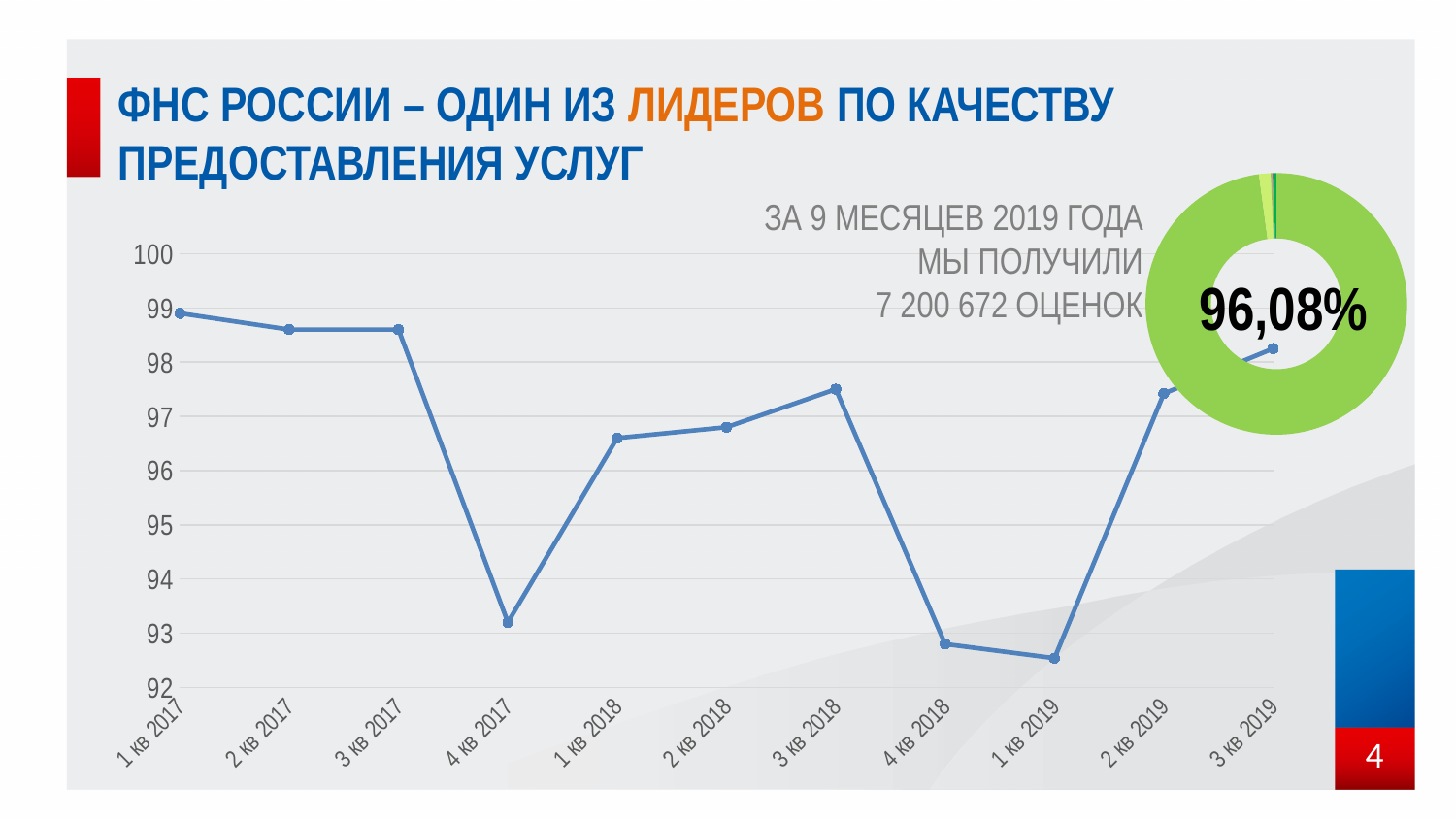
In the line chart, what is the lowest value shown on the vertical axis? 92 In the line chart, do the values rise or fall from 1 кв 2017 to 4 кв 2017? fall In the line chart, is the value for 1 кв 2019 greater or less than 93? less In the line chart, is the value for 1 кв 2017 greater or less than 98? greater In the line chart, do the values rise or fall from 1 кв 2019 to 3 кв 2019? rise In the line chart, which is larger: the value for 4 кв 2017 or the value for 3 кв 2018? 3 кв 2018 In the line chart, is the value for 4 кв 2017 greater or less than 94? less What kind of chart is the large chart on the left of the slide showing quarters from 1 кв 2017 to 3 кв 2019? line chart What percentage is printed in the centre of the donut chart in the top right of the slide? 96,08% In the line chart, how many quarterly data points are plotted? 11 In the line chart, which is larger: the value for 2 кв 2017 or the value for 1 кв 2018? 2 кв 2017